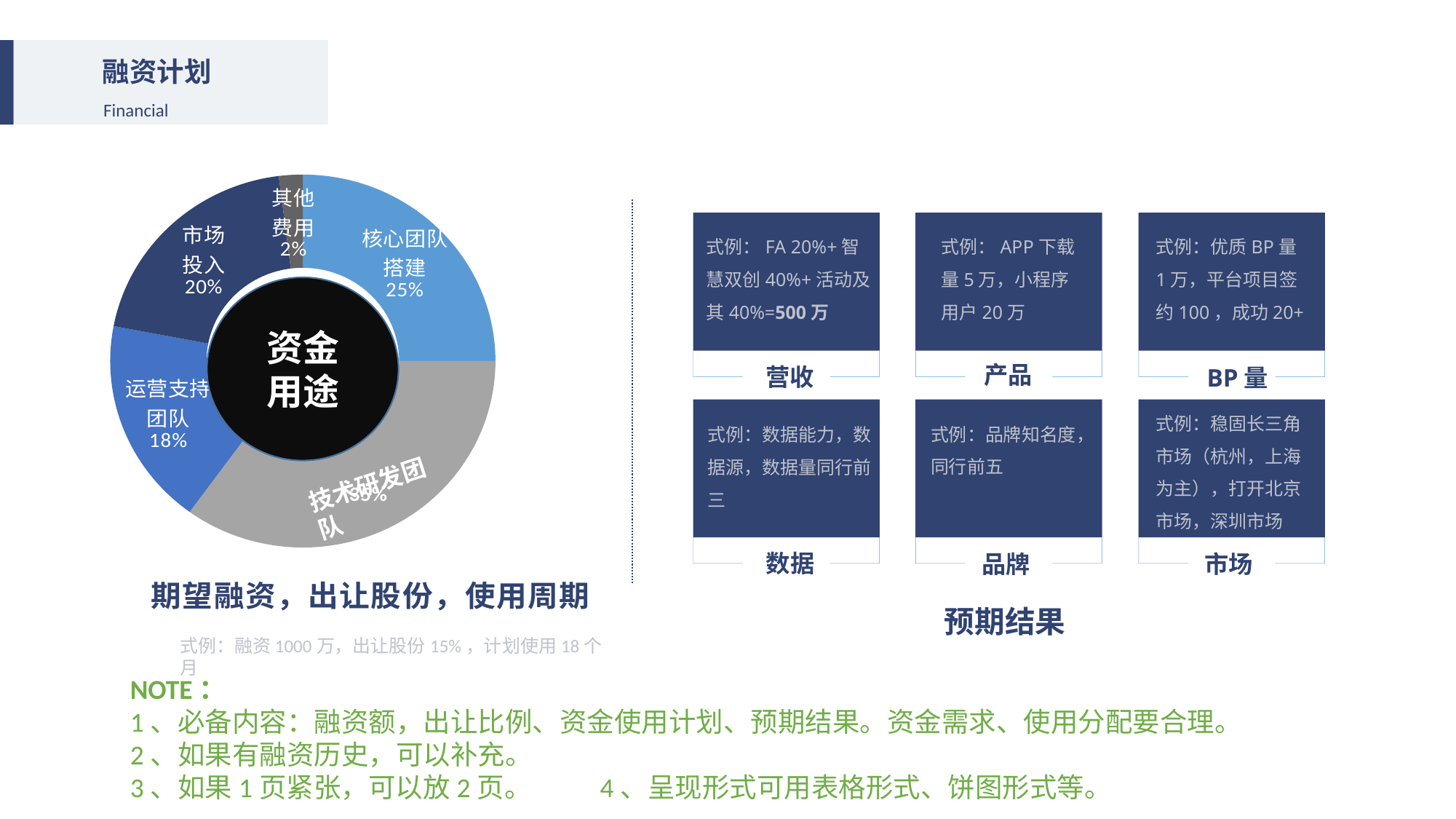
Which category has the largest share in the 资金用途 chart? 技术研发团队 What percentage of the funds is allocated to 运营支持团队? 18% What percentage of the funds is allocated to 其他费用? 2% How many categories are shown in the 资金用途 chart? 5 What percentage of the funds is allocated to 市场投入? 20% What is the difference between the shares of 市场投入 and 其他费用? 18% What is the difference between the shares of 核心团队搭建 and 市场投入? 5% What percentage of the funds is allocated to 核心团队搭建? 25% Which is larger in the 资金用途 chart: 市场投入 or 运营支持团队? 市场投入 What is the title in the centre of the doughnut chart? 资金用途 Which category has the smallest share in the 资金用途 chart? 其他费用 What kind of chart is shown on the left of the slide? Doughnut (pie) chart